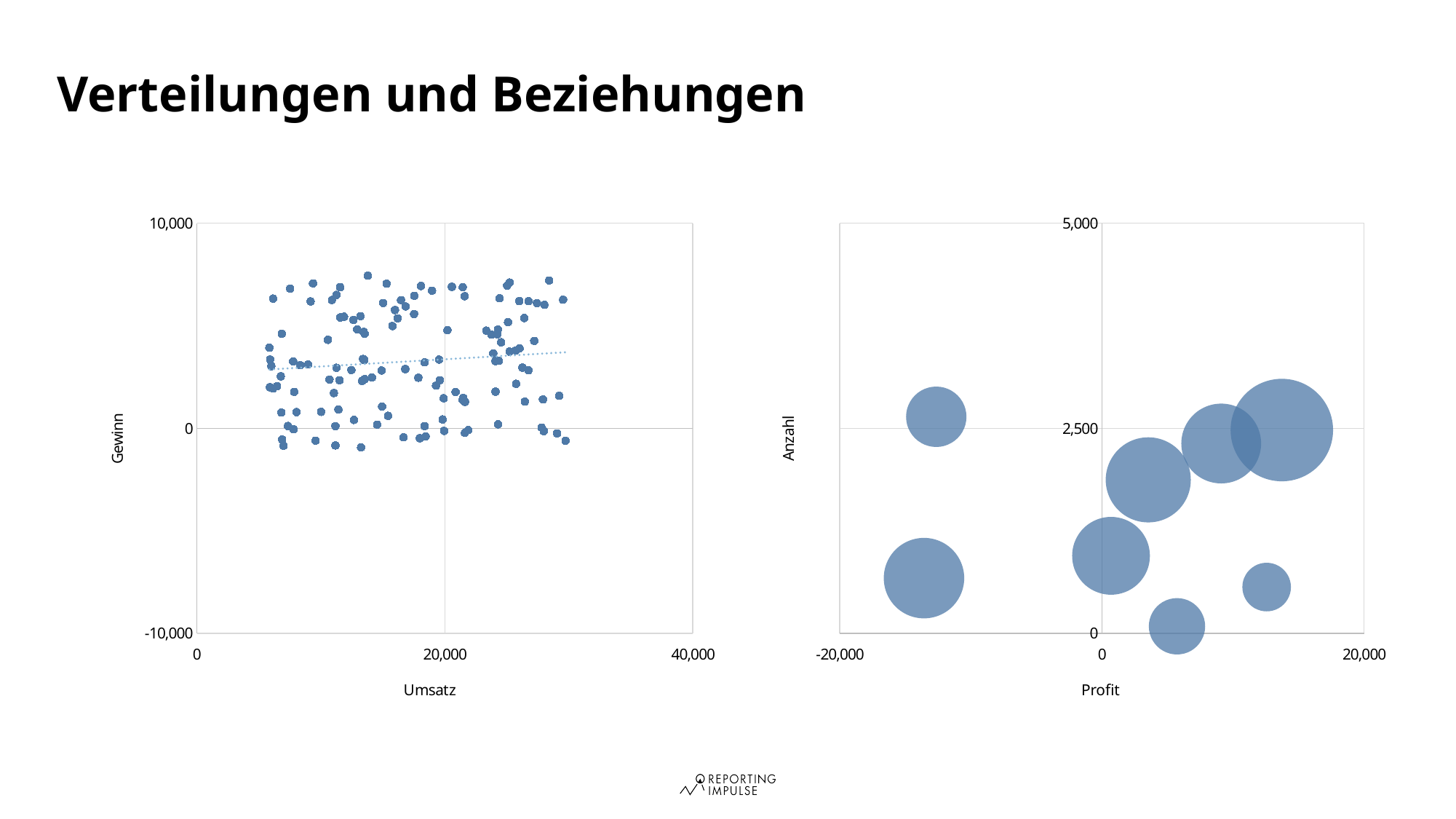
In the right chart, is the Anzahl of the lowest bubble greater or less than 2,500? less In the right chart, how many bubbles are plotted? 8 In the right chart, is the Profit of the leftmost bubble greater or less than -10,000? less In the right chart, what variable is plotted on the y axis? Anzahl In the left chart, does the dotted trend line rise or fall as Umsatz increases? rise What kind of chart is the right chart (Profit vs. Anzahl)? bubble chart In the left chart, is the Umsatz of the rightmost point greater or less than 20,000? greater In the left chart, what variable is plotted on the x axis? Umsatz In the right chart, how many bubbles have a negative Profit value? 2 What kind of chart is the left chart (Umsatz vs. Gewinn)? scatter chart